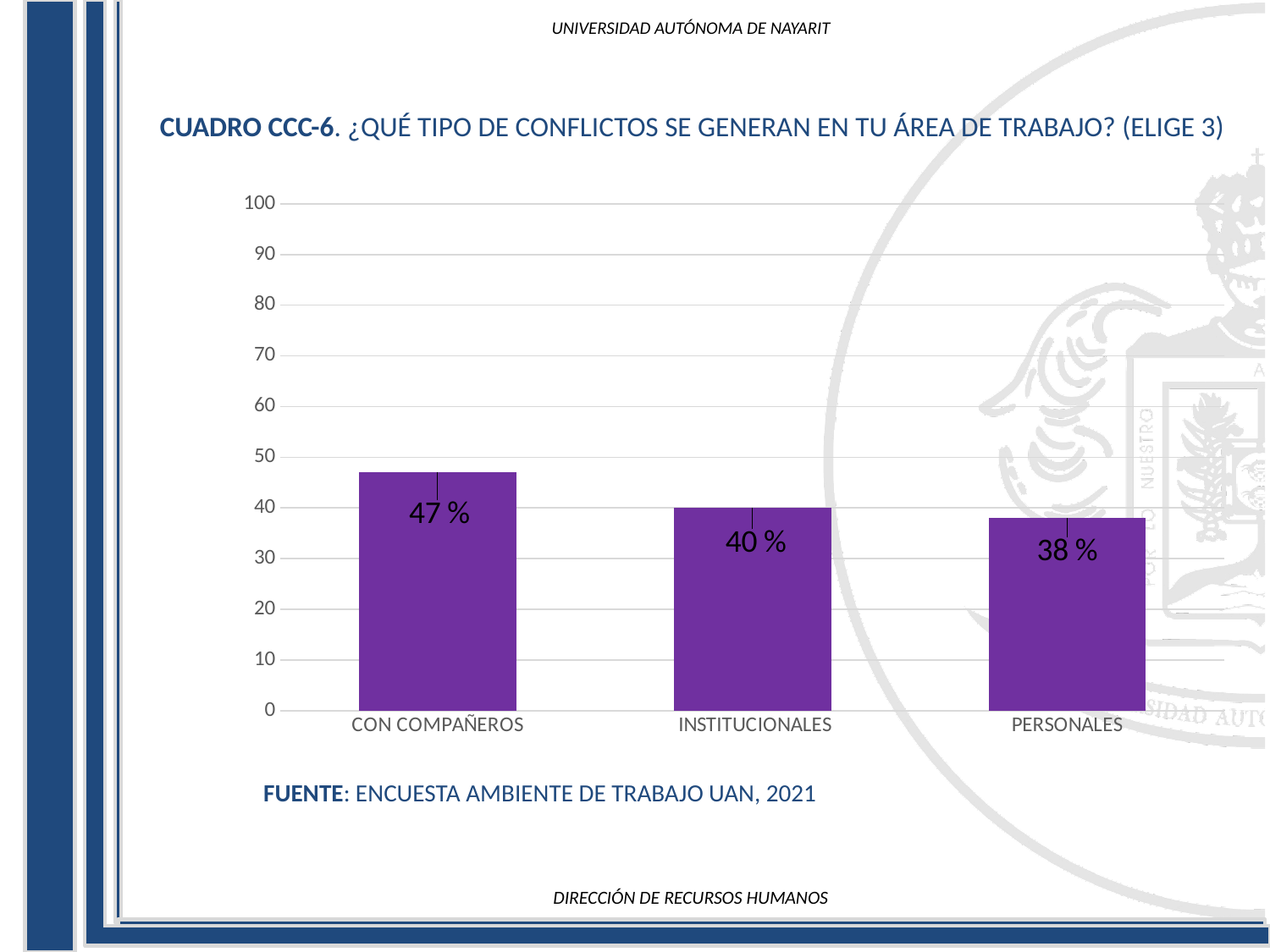
Which category has the lowest value? PERSONALES Is the value for CON COMPAÑEROS greater or less than 50? less What is the value for INSTITUCIONALES? 40 % What kind of chart is shown on the slide? bar chart What is the value for CON COMPAÑEROS? 47 % What is the difference between the values for CON COMPAÑEROS and PERSONALES? 9 % What source is cited below the chart? ENCUESTA AMBIENTE DE TRABAJO UAN, 2021 How many categories are shown on the x axis? 3 What is the value for PERSONALES? 38 % What is the difference between the values for CON COMPAÑEROS and INSTITUCIONALES? 7 % Which category has the highest value? CON COMPAÑEROS Which is larger, the value for INSTITUCIONALES or the value for PERSONALES? INSTITUCIONALES